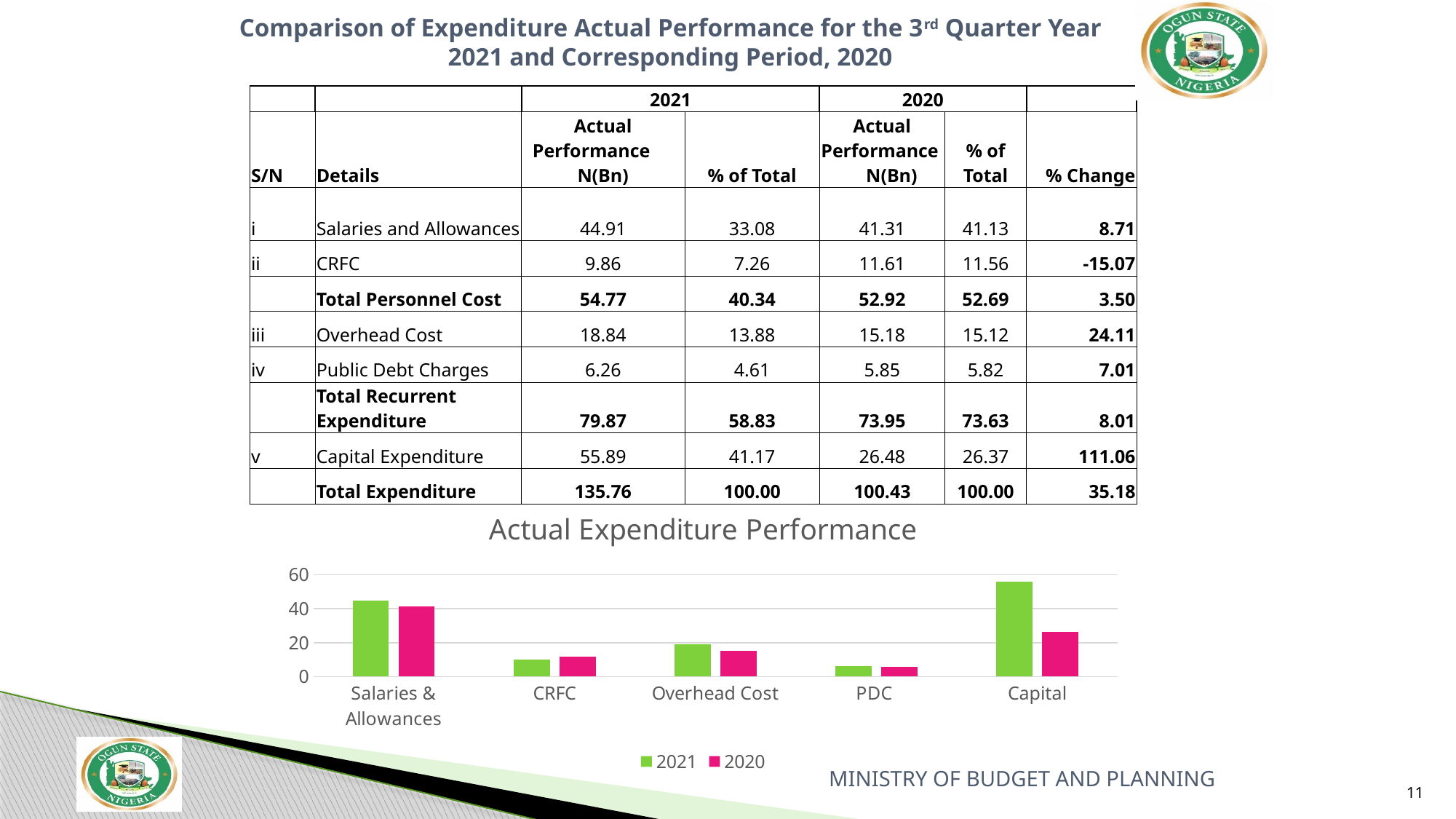
In the 'Actual Expenditure Performance' chart, which is larger for CRFC: the 2021 bar or the 2020 bar? 2020 In the 'Actual Expenditure Performance' chart, is the 2020 value for Overhead Cost greater or less than 20? less How many categories are shown on the x axis of the 'Actual Expenditure Performance' chart? 5 In the 'Actual Expenditure Performance' chart, is the 2021 value for Capital greater or less than 40? greater What colour are the 2020 bars in the 'Actual Expenditure Performance' chart? pink In the 'Actual Expenditure Performance' chart, which category has the lowest 2020 bar? PDC In the 'Actual Expenditure Performance' chart, is the 2021 value for Salaries & Allowances greater or less than 40? greater In the 'Actual Expenditure Performance' chart, which category has the highest 2021 bar? Capital What kind of chart is shown under the title 'Actual Expenditure Performance'? bar chart What is the title of the bar chart on the slide? Actual Expenditure Performance In the 'Actual Expenditure Performance' chart, which is larger for Capital: the 2021 bar or the 2020 bar? 2021 How many series does the legend of the 'Actual Expenditure Performance' chart list? 2